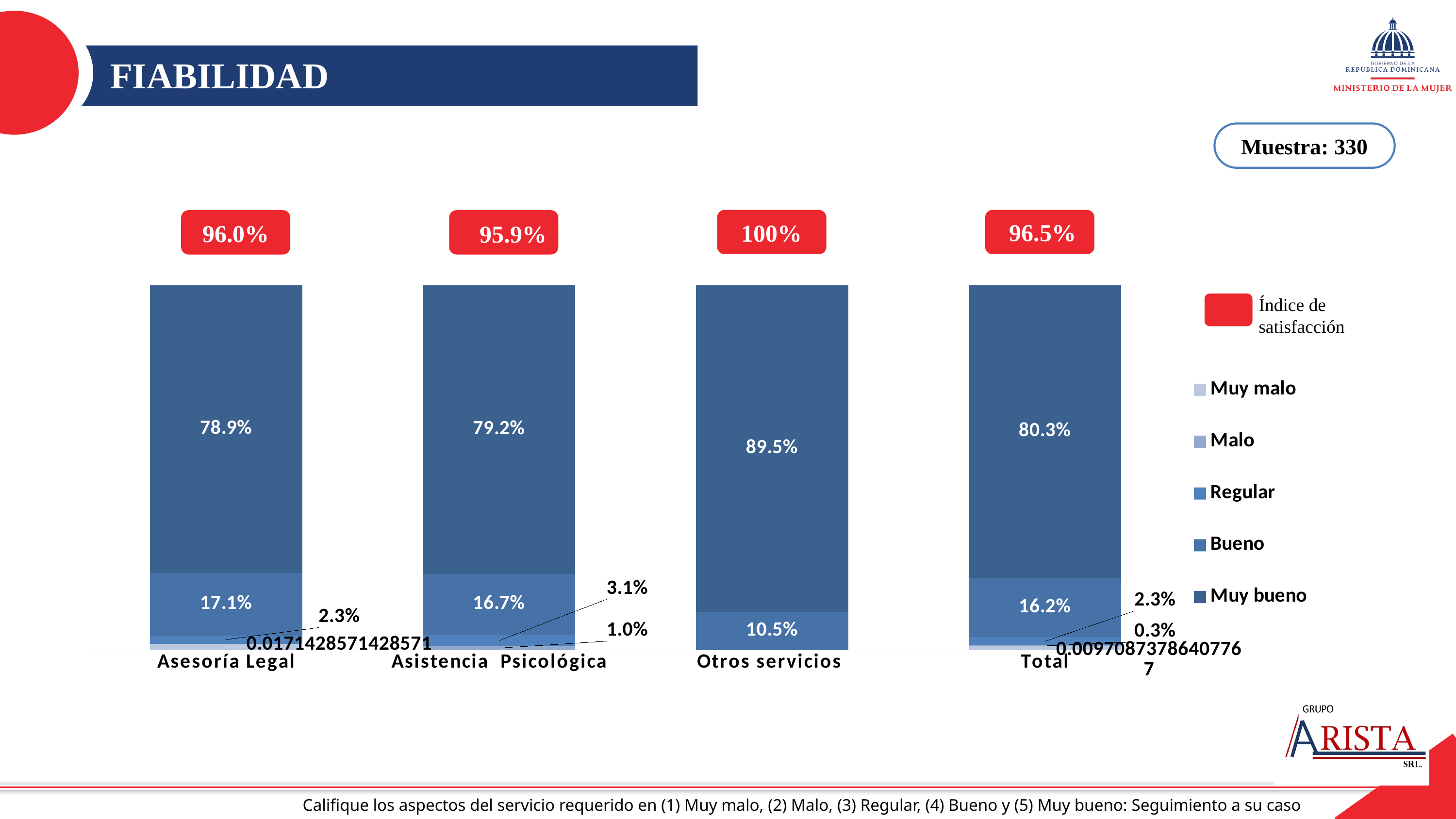
Which category has the lowest Bueno value? Otros servicios What is the Muy bueno value for Otros servicios? 89.5% What is the Índice de satisfacción shown for Total? 96.5% What type of chart is shown on the slide? stacked bar chart How many series does the chart legend list (excluding the satisfaction index)? 5 What is the difference between the Muy bueno values for Total and Asesoría Legal? 1.4% What is the Bueno value for Asesoría Legal? 17.1% Which is larger, the Índice de satisfacción for Asesoría Legal or for Asistencia Psicológica? Asesoría Legal What is the sample size (Muestra) shown on the slide? 330 What is the Regular value for Asistencia Psicológica? 3.1% How many categories are shown on the x axis of the chart? 4 Which category has the highest Muy bueno value? Otros servicios